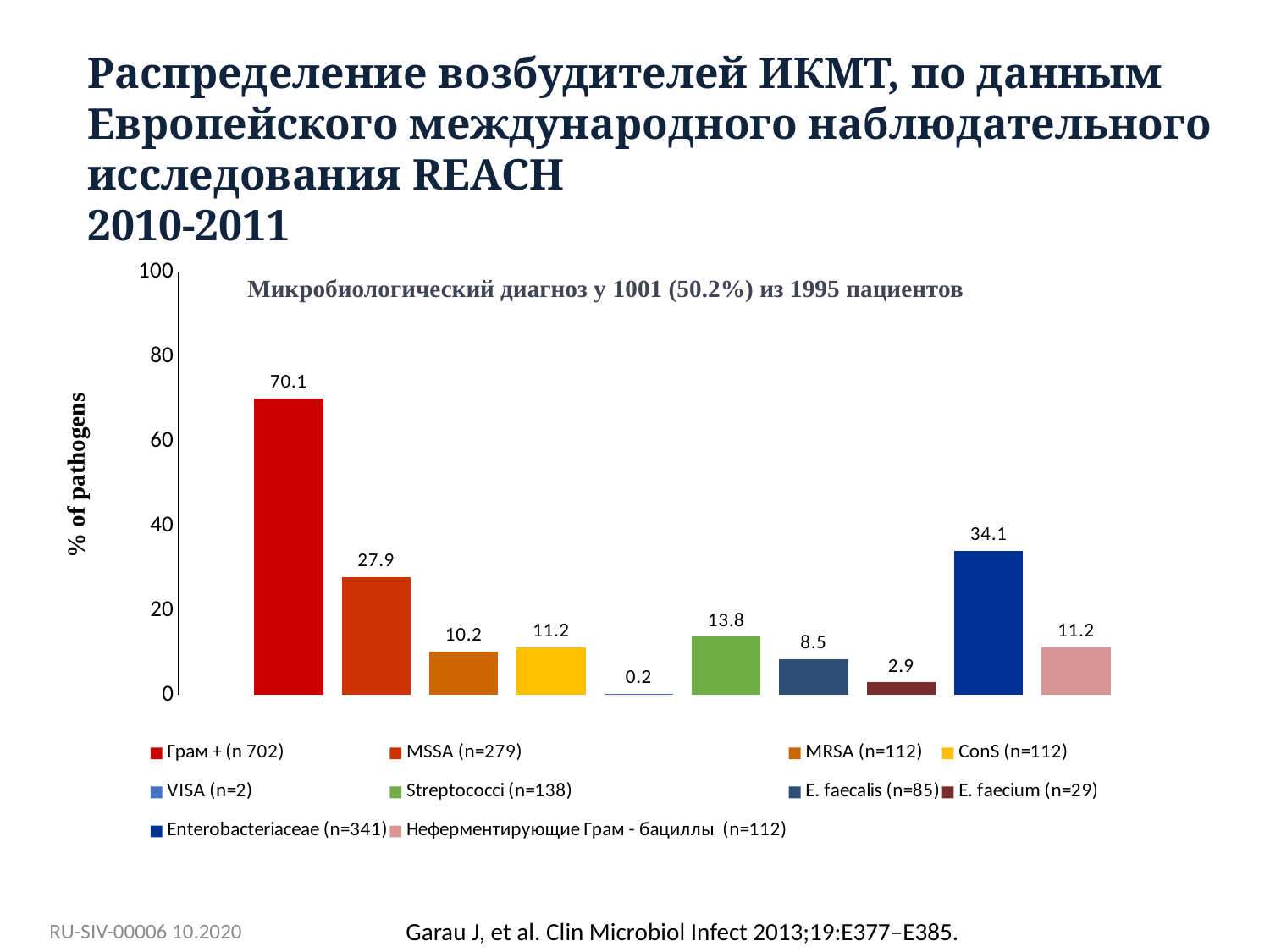
What value is shown for Streptococci (n=138)? 13.8 What value is shown for Enterobacteriaceae (n=341)? 34.1 Which category has the lowest value? VISA (n=2) Is the value for Enterobacteriaceae (n=341) greater or less than 40? less What is the difference between the values for Грам + (n 702) and MSSA (n=279)? 42.2 What value is shown for Грам + (n 702)? 70.1 What value is shown for E. faecium (n=29)? 2.9 What is the label of the vertical axis? % of pathogens What type of chart is shown on the slide? bar chart Which category has the highest value? Грам + (n 702) How many bars are plotted in the chart? 10 Which is larger, the value for MRSA (n=112) or the value for ConS (n=112)? ConS (n=112)